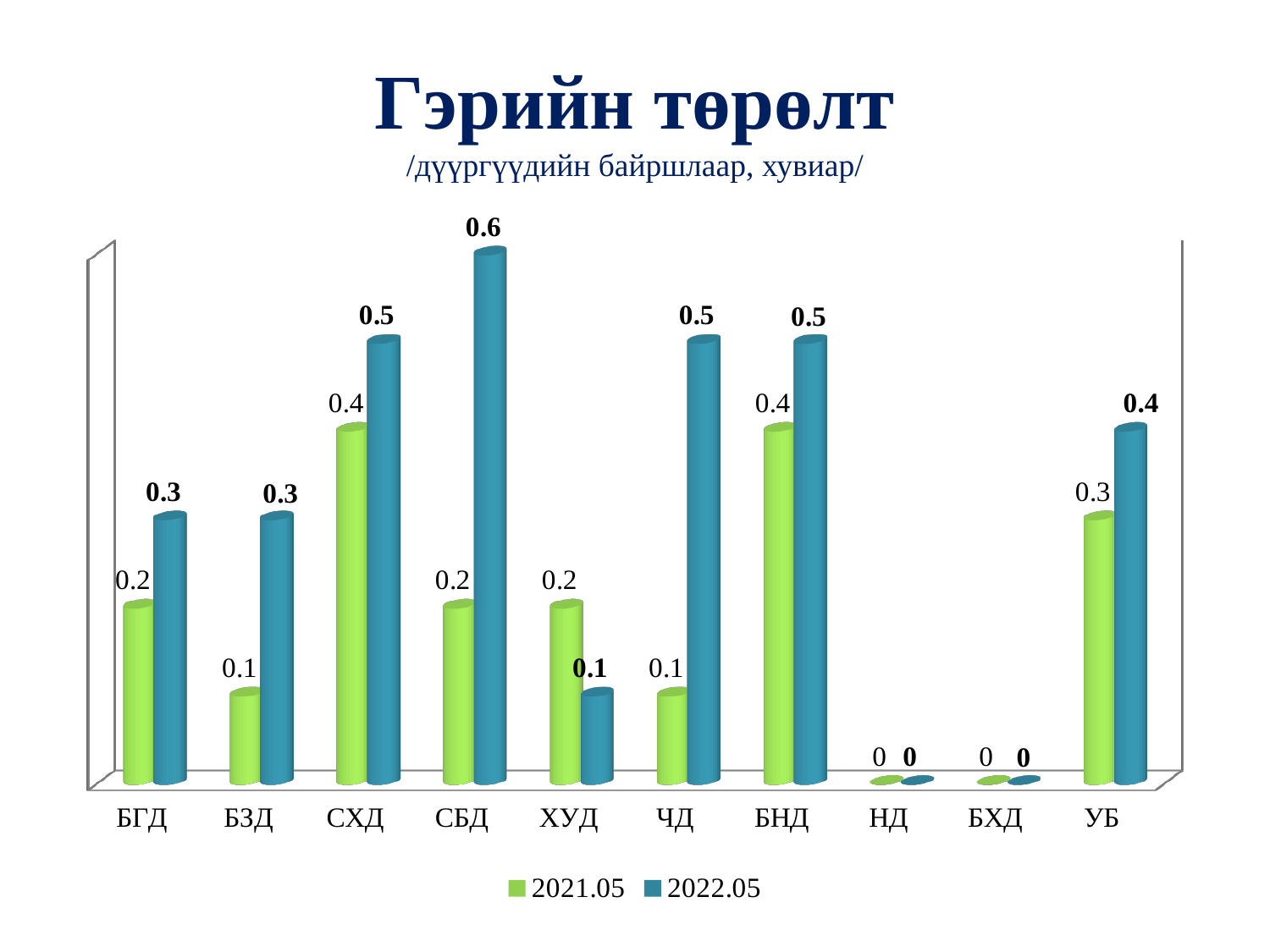
What is the difference between the 2022.05 and 2021.05 values for ЧД? 0.4 Which is larger for ХУД: the 2021.05 value or the 2022.05 value? 2021.05 What is the value for СБД in the 2022.05 series? 0.6 Which category has the highest value in the 2022.05 series? СБД How many categories are shown on the x axis? 10 Which is larger for БЗД: the 2021.05 value or the 2022.05 value? 2022.05 How many series does the legend list? 2 What is the value for СХД in the 2021.05 series? 0.4 What is the value for УБ in the 2022.05 series? 0.4 What kind of chart is shown on the slide? Bar chart What is the value for ХУД in the 2022.05 series? 0.1 What is the difference between the 2022.05 and 2021.05 values for СБД? 0.4